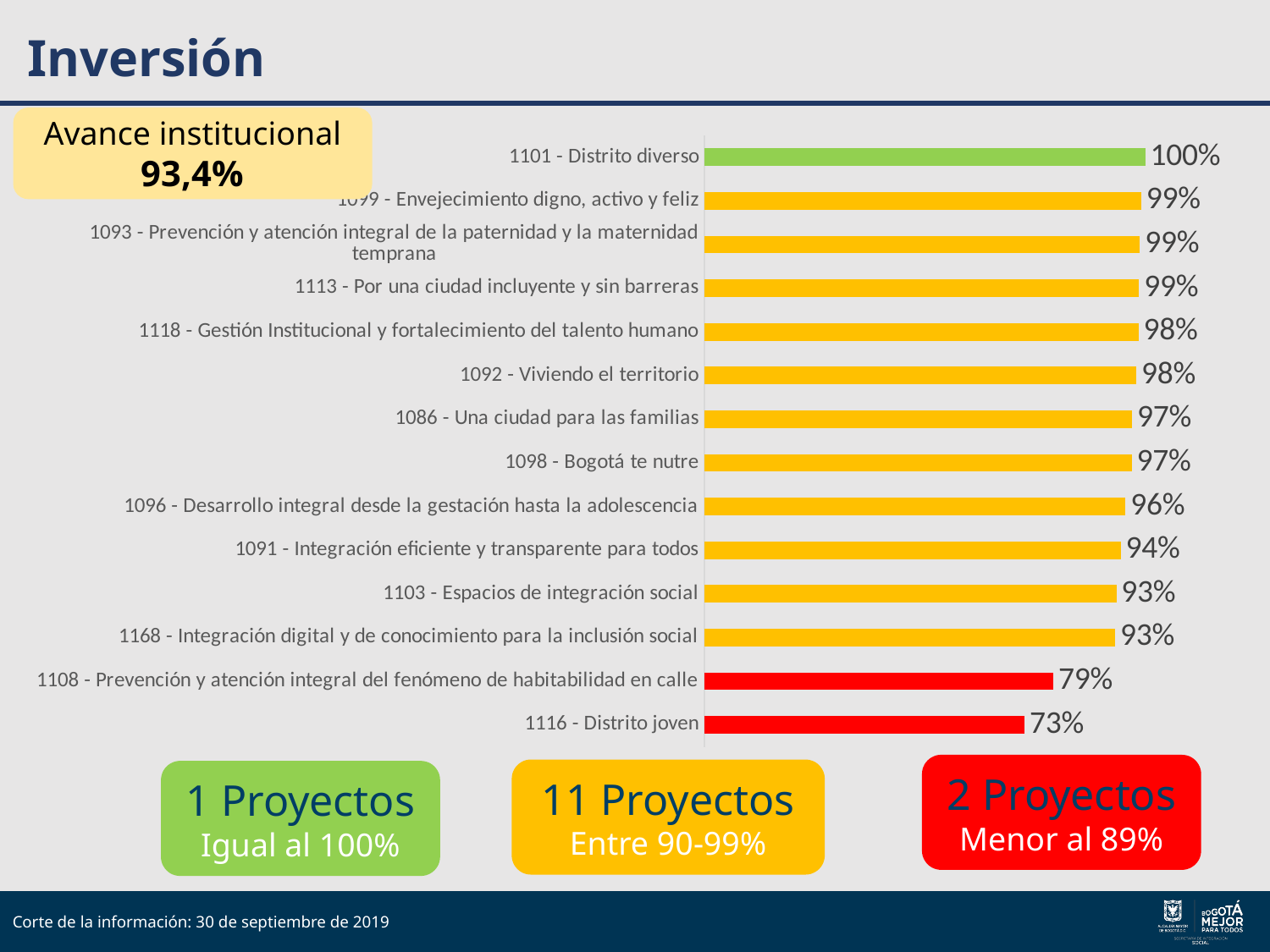
What is the difference between the values for 1101 - Distrito diverso and 1116 - Distrito joven? 27% What is the difference between the values for 1108 - Prevención y atención integral del fenómeno de habitabilidad en calle and 1116 - Distrito joven? 6% How many categories are shown in the chart? 14 What colour is the bar for 1101 - Distrito diverso? Green What is the value for 1091 - Integración eficiente y transparente para todos? 94% Which is larger, the value for 1103 - Espacios de integración social or the value for 1108 - Prevención y atención integral del fenómeno de habitabilidad en calle? 1103 - Espacios de integración social Which category has the highest value? 1101 - Distrito diverso What is the value for 1096 - Desarrollo integral desde la gestación hasta la adolescencia? 96% What is the value for 1108 - Prevención y atención integral del fenómeno de habitabilidad en calle? 79% What kind of chart is shown on the slide? Bar chart Which category has the lowest value? 1116 - Distrito joven What is the value for 1116 - Distrito joven? 73%